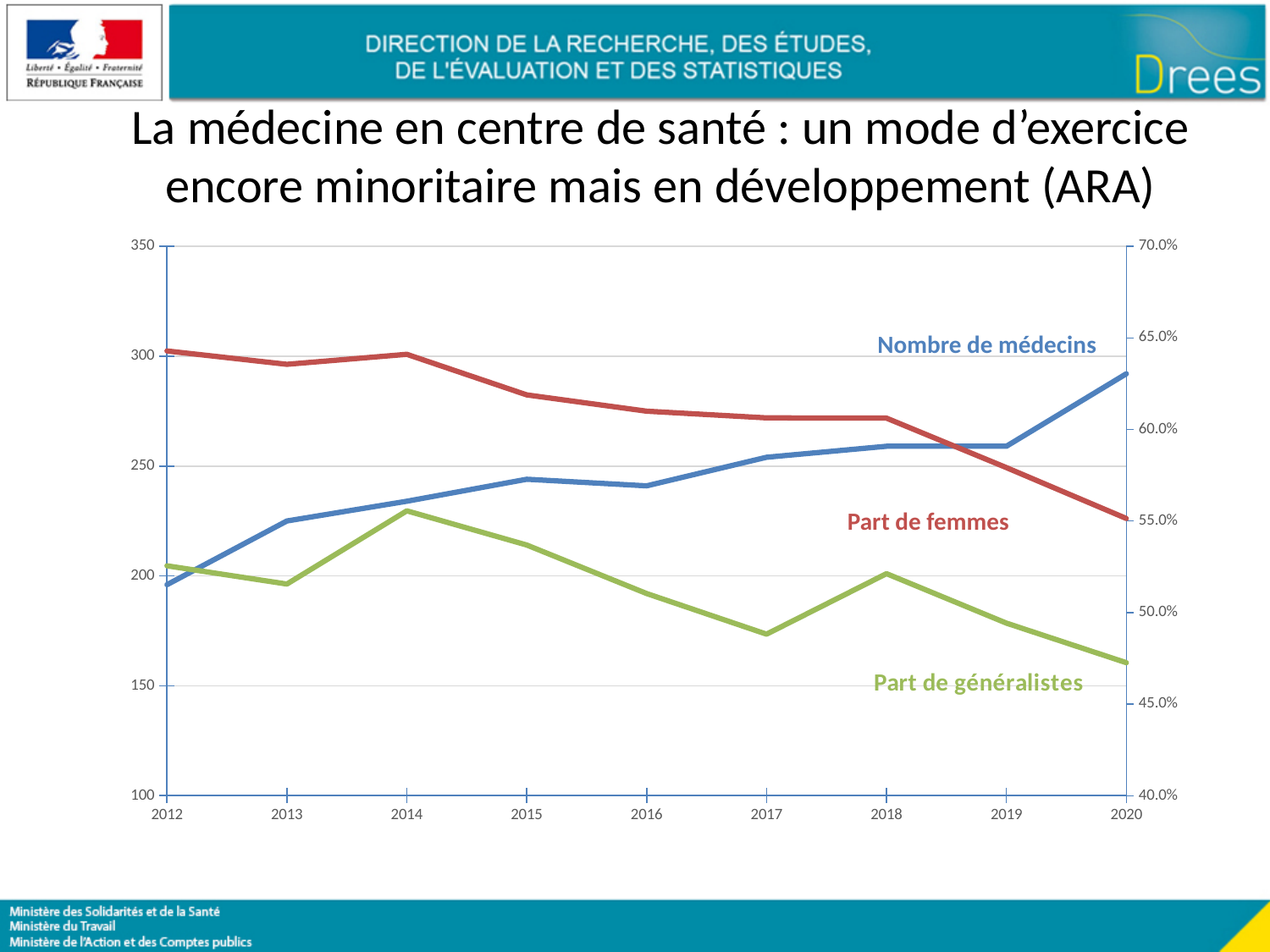
In which year is 'Nombre de médecins' highest? 2020 Does the 'Part de femmes' line rise or fall overall from 2012 to 2020? fall How many series are plotted on the chart? 3 Is the value for 'Part de généralistes' in 2020 greater or less than 50.0%? less Is the value for 'Part de femmes' in 2012 greater or less than 60.0%? greater How many years are shown along the x axis of the chart? 9 Does the 'Nombre de médecins' line rise or fall overall from 2012 to 2020? rise Is the value for 'Nombre de médecins' in 2020 greater or less than 250? greater In which year is 'Part de généralistes' highest? 2014 In which year is 'Nombre de médecins' lowest? 2012 In 2020, which is larger, 'Part de femmes' or 'Part de généralistes'? Part de femmes What kind of chart is shown on the slide? line chart